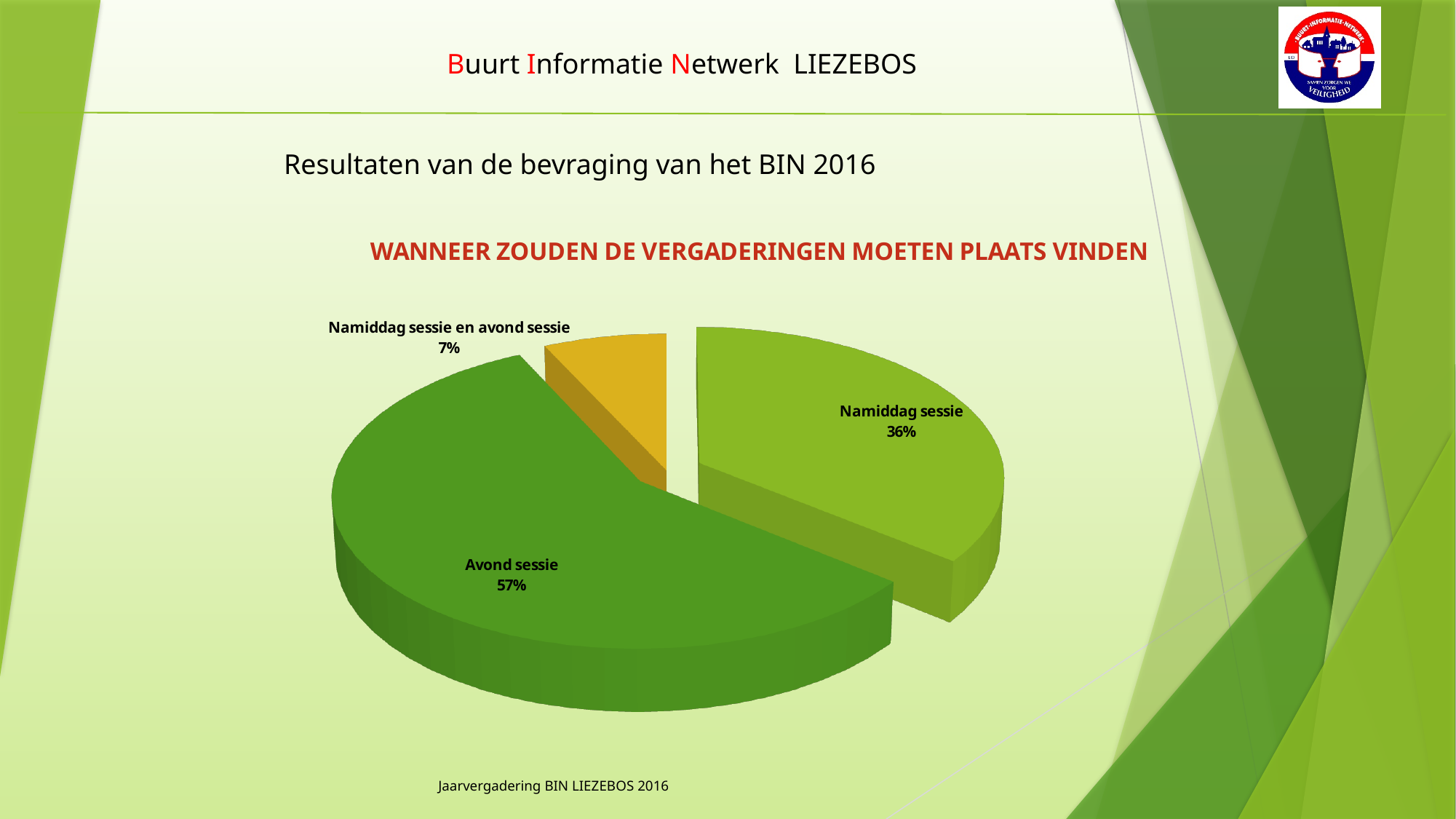
Which category has the smallest slice of the pie? Namiddag sessie en avond sessie What kind of chart is shown on the slide? Pie chart What colour is the slice for "Namiddag sessie en avond sessie"? Yellow What is the difference in percentage points between "Namiddag sessie" and "Namiddag sessie en avond sessie"? 29 Which is larger, the slice for "Namiddag sessie" or the slice for "Namiddag sessie en avond sessie"? Namiddag sessie How many slices does the pie chart have? 3 What is the title of the chart? WANNEER ZOUDEN DE VERGADERINGEN MOETEN PLAATS VINDEN What share of the pie does "Namiddag sessie" have? 36% What is the difference in percentage points between "Avond sessie" and "Namiddag sessie"? 21 What share of the pie does "Avond sessie" have? 57% Which category has the largest slice of the pie? Avond sessie What share of the pie does "Namiddag sessie en avond sessie" have? 7%